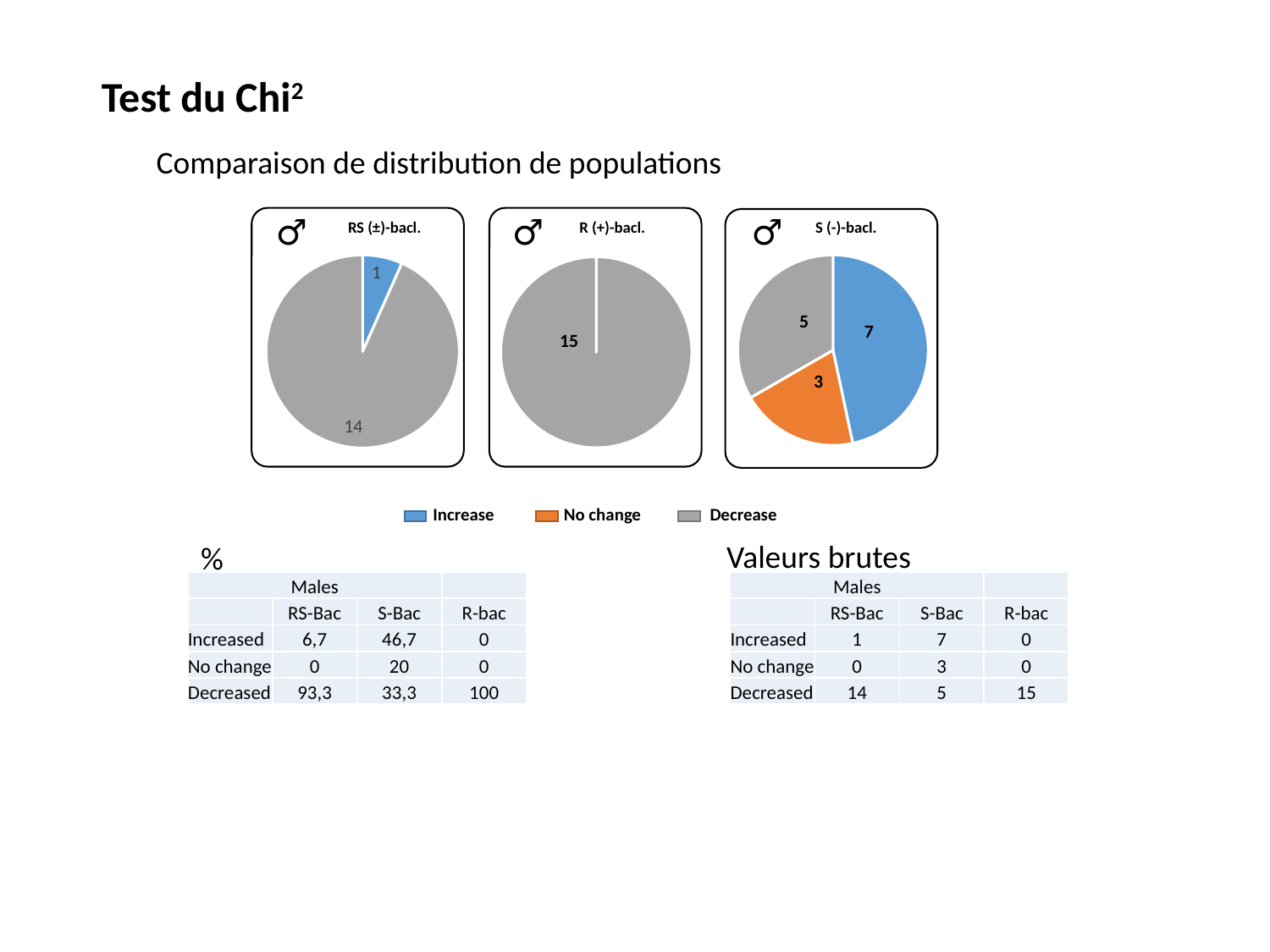
In the S (-)-bacl. pie chart, what is the value of the No change slice? 3 In the S (-)-bacl. pie chart, which category has the smallest slice? No change In the S (-)-bacl. pie chart, what share of the total does the Increase slice represent? 46,7% In the S (-)-bacl. pie chart, which category has the largest slice? Increase In the RS (±)-bacl. pie chart, what is the value of the Increase slice? 1 In the R (+)-bacl. pie chart, what is the value of the Decrease slice? 15 What kind of chart is used in the RS (±)-bacl. panel? pie chart In the RS (±)-bacl. pie chart, what is the value of the Decrease slice? 14 How many slices does the S (-)-bacl. pie chart have? 3 In the RS (±)-bacl. pie chart, which is larger, the Increase slice or the Decrease slice? Decrease How many categories does the shared legend list? 3 In the S (-)-bacl. pie chart, what is the difference between the Increase slice and the Decrease slice? 2